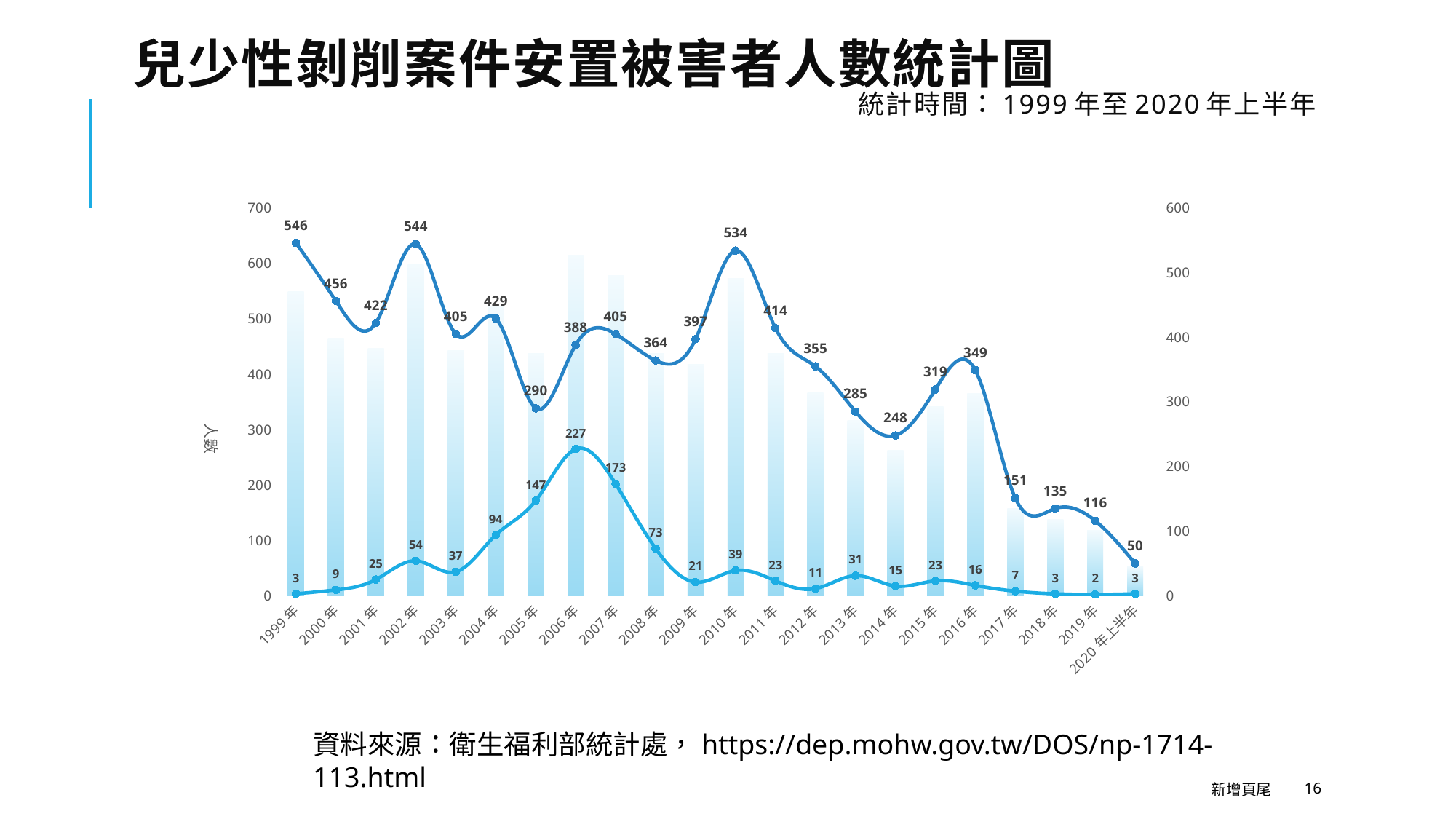
How many year categories are shown on the x axis? 22 What is the value of the upper (darker) line for 2005年? 290 What is the title of the chart on the slide? 兒少性剝削案件安置被害者人數統計圖 In which year does the upper (darker) line reach its lowest value? 2020年上半年 In which year does the lower (lighter) line reach its highest value? 2006年 What is the value of the upper (darker) line for 2010年? 534 For the lower (lighter) line, which year has the larger value: 2007年 or 2008年? 2007年 On the left axis, is the bar for 2006年 greater or less than 600? greater What is the difference between the upper line's values for 2016年 and 2017年? 198 Does the upper (darker) line rise or fall from 2016年 to 2020年上半年? Fall What is the value of the lower (lighter) line for 2006年? 227 What kind of chart is this? Combined bar and line chart